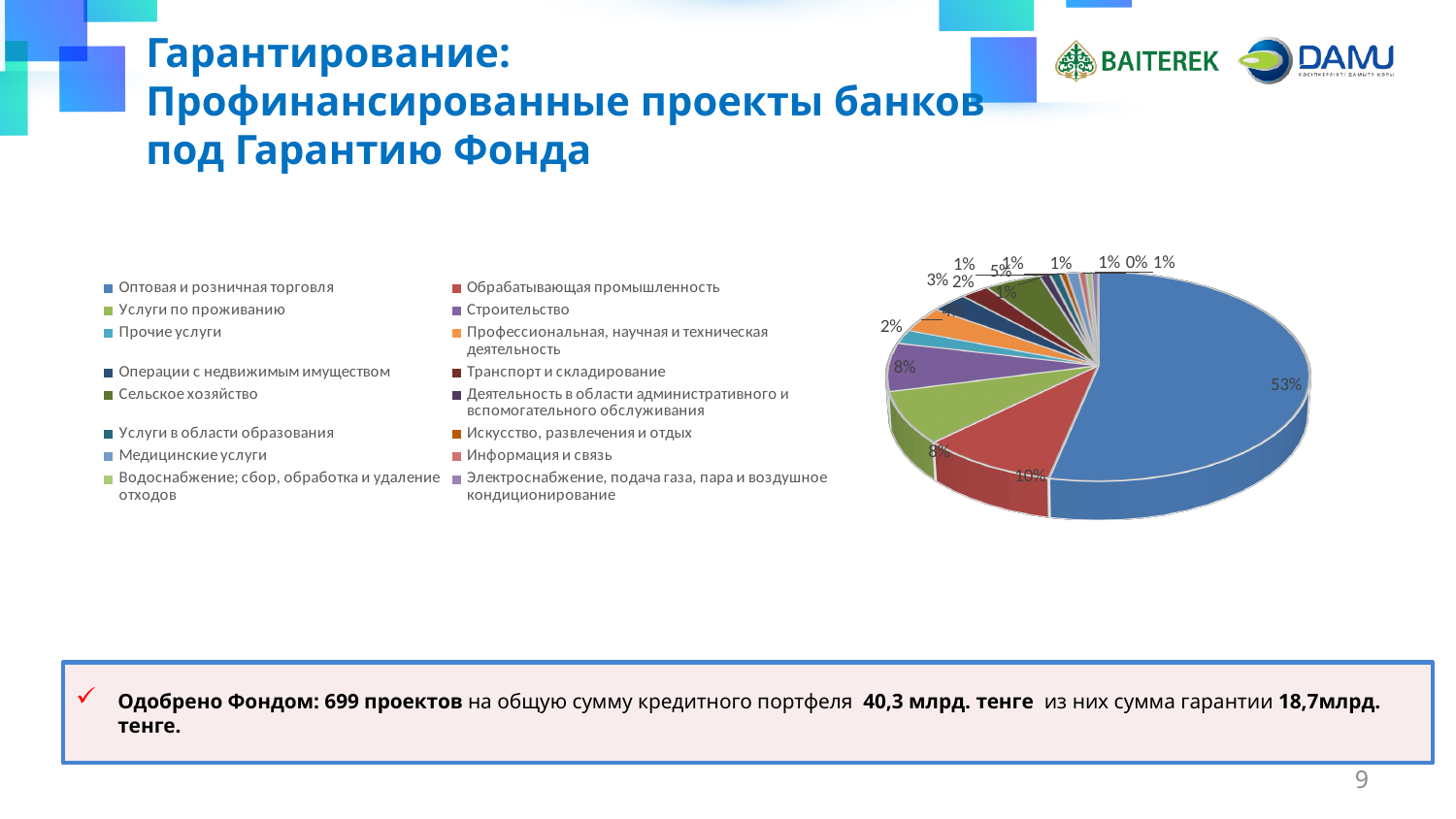
What kind of chart is shown on the slide? Pie chart How many categories does the legend list? 16 What share of the pie does Обрабатывающая промышленность have? 10% What share of the pie does Оптовая и розничная торговля have? 53% What share of the pie does Строительство have? 8% Which category has the largest share of the pie? Оптовая и розничная торговля What colour is the largest slice of the pie? Blue What is the difference in percentage points between Оптовая и розничная торговля and Обрабатывающая промышленность? 43 percentage points Which is larger: the share of Обрабатывающая промышленность or the share of Услуги по проживанию? Обрабатывающая промышленность Which legend entry is shown in red? Обрабатывающая промышленность What is the combined share of Услуги по проживанию and Строительство? 16%